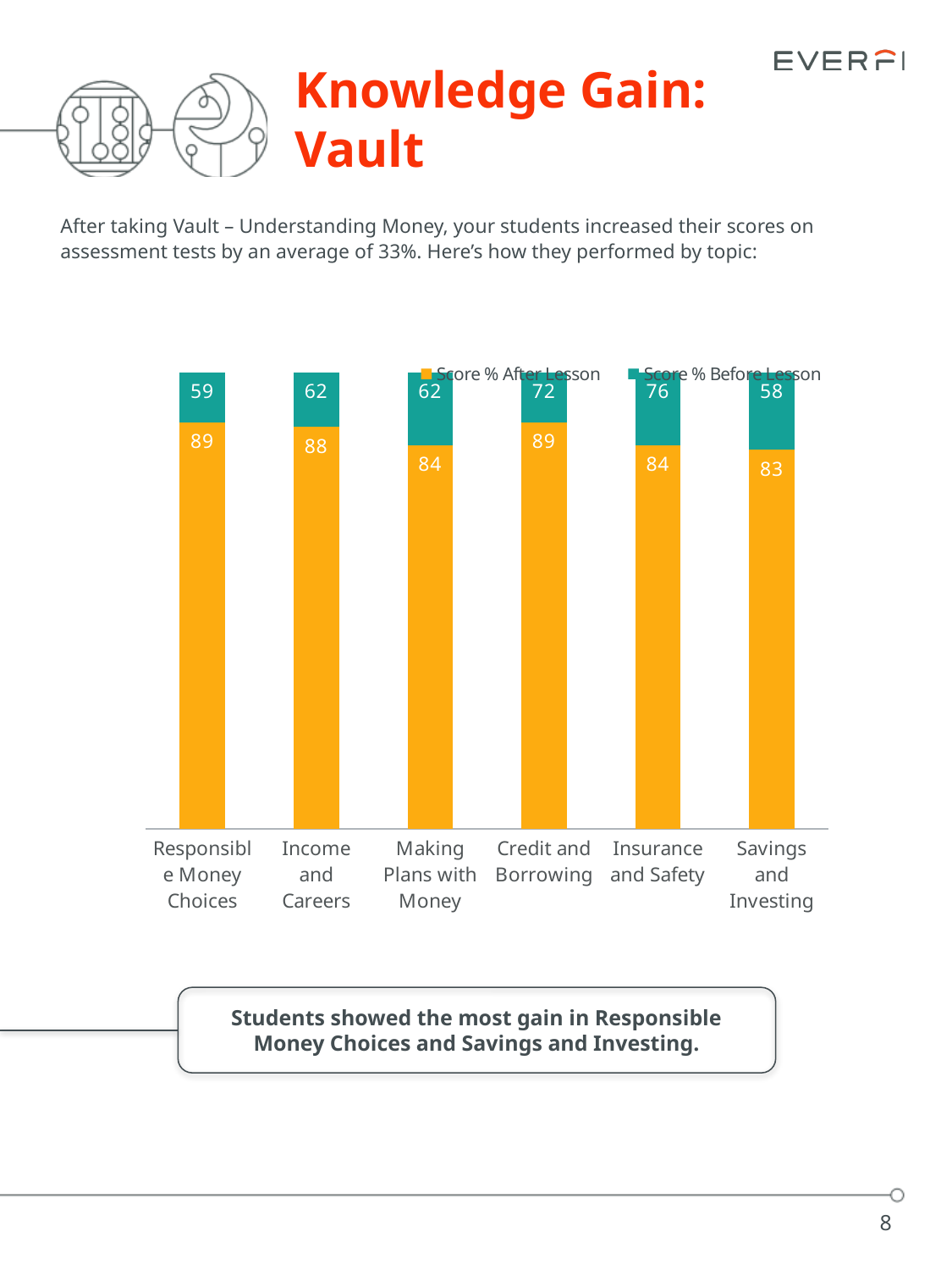
What is the Score % After Lesson for Credit and Borrowing? 89 Which topic has the lowest Score % After Lesson? Savings and Investing What kind of chart is shown on the slide? Stacked bar chart Which topic has the lowest Score % Before Lesson? Savings and Investing What is the Score % Before Lesson for Insurance and Safety? 76 Which topic has the highest Score % Before Lesson? Insurance and Safety How many topics are shown on the x axis of the chart? 6 How many series does the chart legend list? 2 What is the difference between the Score % After Lesson and the Score % Before Lesson for Responsible Money Choices? 30 What is the total of the stacked bar for Income and Careers? 150 What is the Score % Before Lesson for Savings and Investing? 58 Is the Score % Before Lesson higher for Credit and Borrowing or for Making Plans with Money? Credit and Borrowing